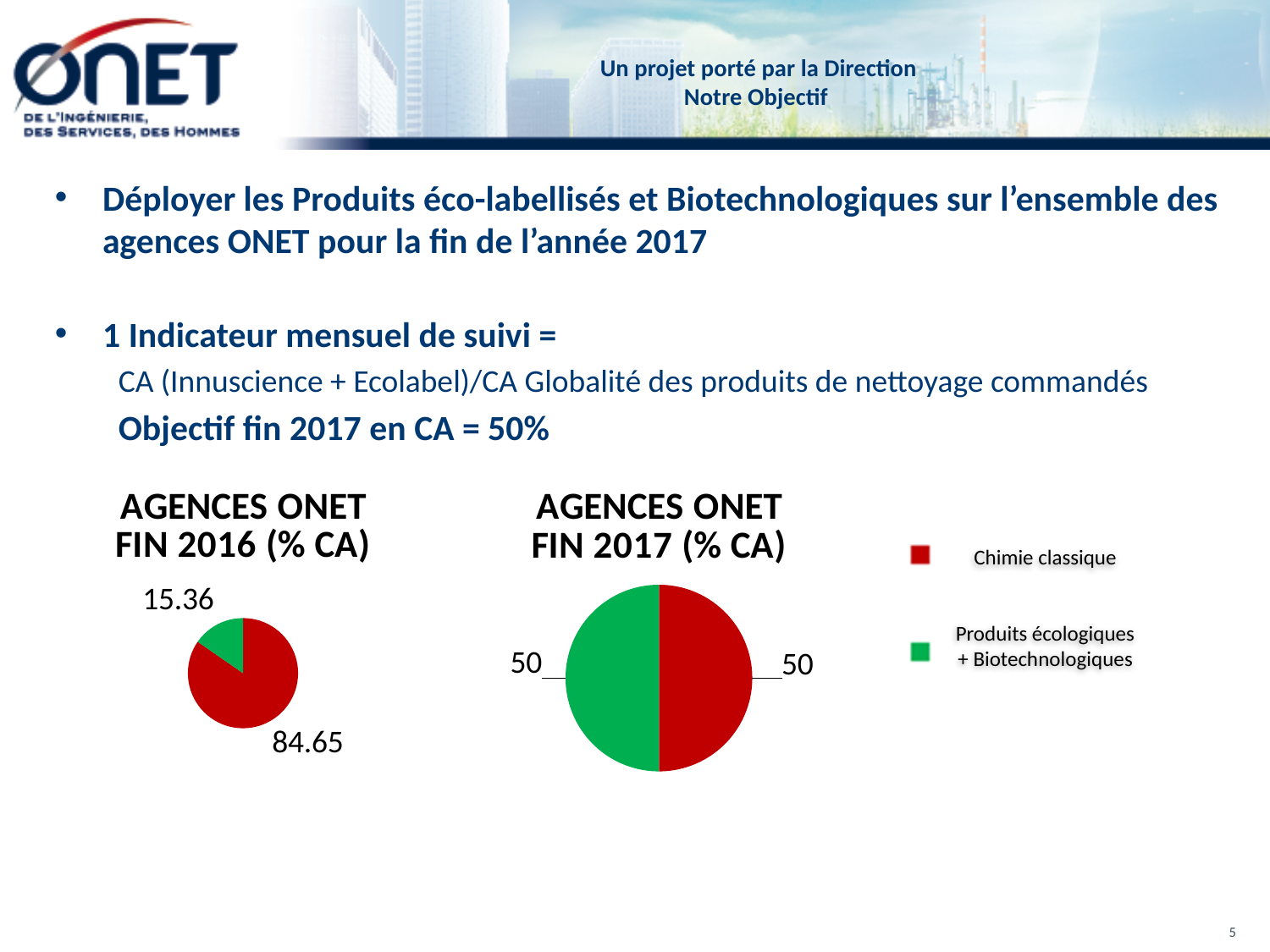
In the 'AGENCES ONET FIN 2016 (% CA)' chart, which category has the largest slice? Chimie classique How many entries does the legend shared by the two pie charts list? 2 What colour represents Chimie classique in the pie charts? Red In the 'AGENCES ONET FIN 2017 (% CA)' chart, what is the value for Produits écologiques + Biotechnologiques? 50 In the 'AGENCES ONET FIN 2016 (% CA)' chart, what is the value for Chimie classique? 84.65 In the 'AGENCES ONET FIN 2016 (% CA)' chart, which category has the smallest slice? Produits écologiques + Biotechnologiques What kind of chart is the 'AGENCES ONET FIN 2016 (% CA)' chart? Pie chart In the 'AGENCES ONET FIN 2016 (% CA)' chart, what is the difference between the Chimie classique value and the Produits écologiques + Biotechnologiques value? 69.29 In the 'AGENCES ONET FIN 2016 (% CA)' chart, is the Chimie classique slice larger or smaller than the Produits écologiques + Biotechnologiques slice? Larger In the 'AGENCES ONET FIN 2016 (% CA)' chart, what is the value for Produits écologiques + Biotechnologiques? 15.36 In the 'AGENCES ONET FIN 2017 (% CA)' chart, what is the value for Chimie classique? 50 How many slices does the 'AGENCES ONET FIN 2017 (% CA)' pie chart have? 2